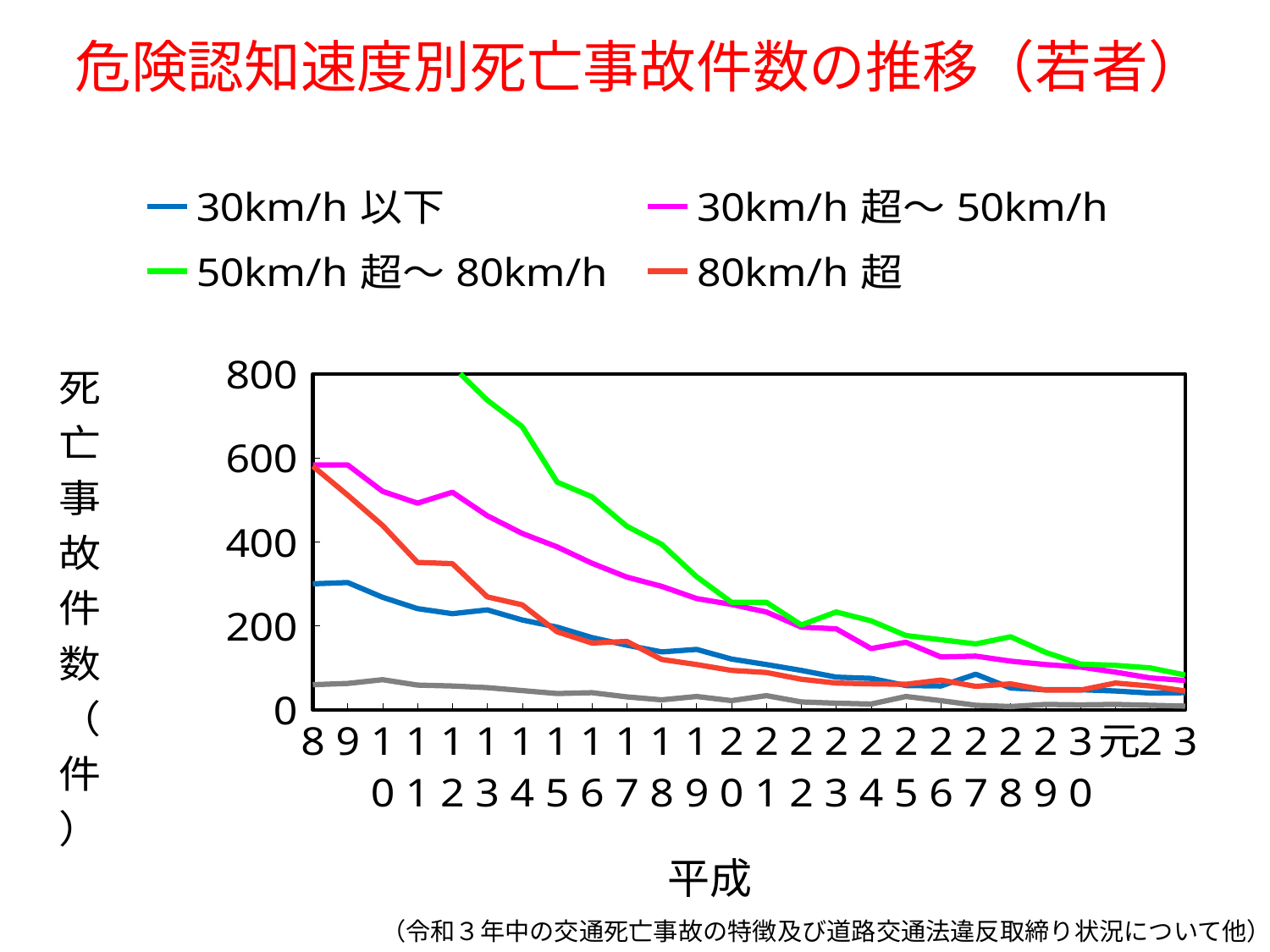
Is the value for 30km/h 超～50km/h at 令和3 greater or less than 200? less What is the label of the x axis? 平成 Do the values for 50km/h 超～80km/h rise or fall from 平成12 to 令和3? fall Is the value for 50km/h 超～80km/h at 平成15 greater or less than 400? greater Is the value for 80km/h 超 at 平成8 greater or less than 400? greater What kind of chart is shown on the slide? line chart At 平成8, which is larger: 30km/h 超～50km/h or 30km/h 以下? 30km/h 超～50km/h How many series does the legend list? 4 What is the title of the chart? 危険認知速度別死亡事故件数の推移（若者） Which series has the highest value at 平成15? 50km/h 超～80km/h